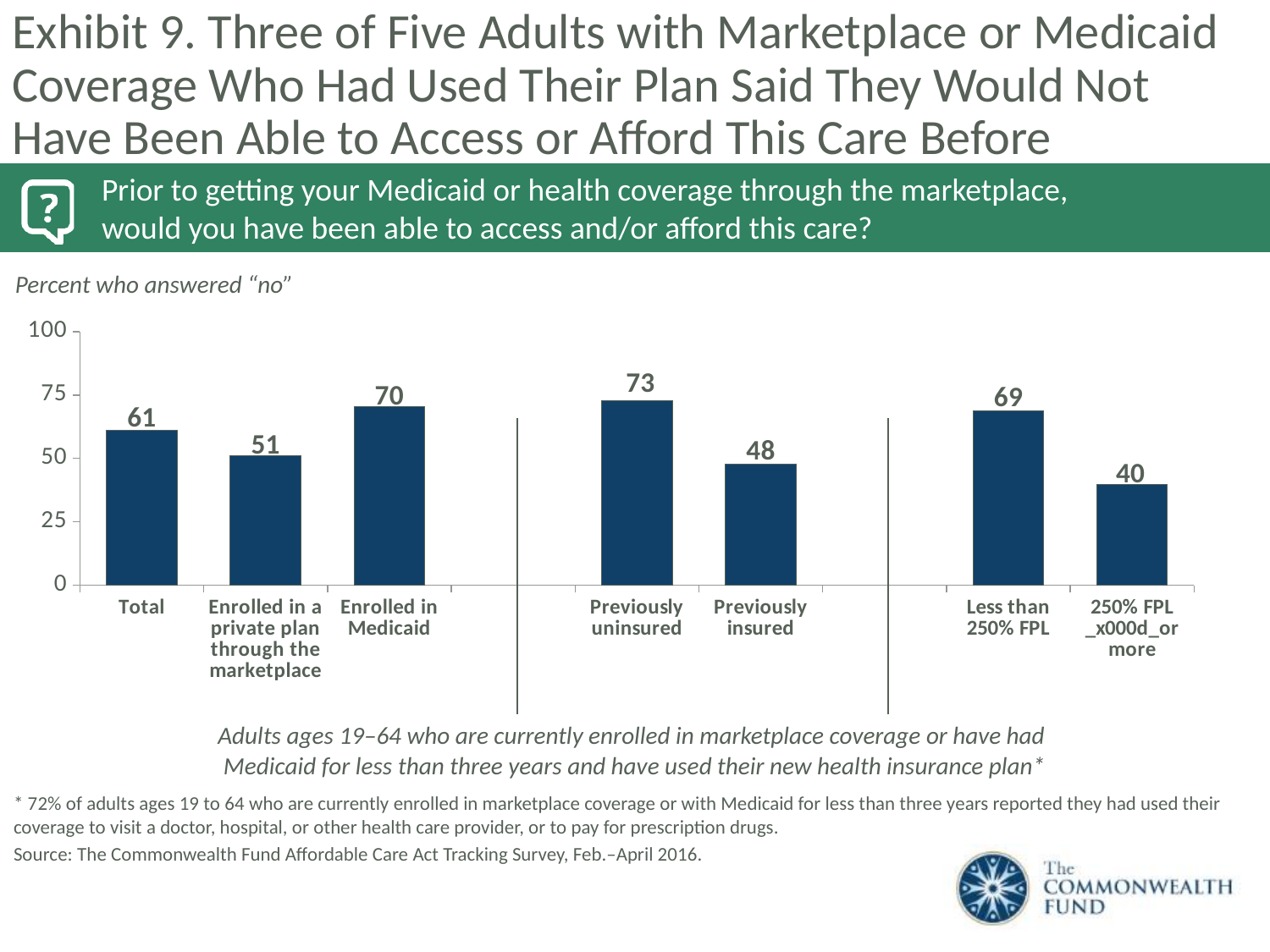
Which is larger, the value for Enrolled in Medicaid or the value for Enrolled in a private plan through the marketplace? Enrolled in Medicaid What is the value for Previously insured? 48 What is the difference between the values for Previously uninsured and Previously insured? 25 What kind of chart is shown on the slide? bar chart What does the label above the chart say the values represent? Percent who answered "no" What is the value for Enrolled in Medicaid? 70 What is the value for Less than 250% FPL? 69 Is the value for Enrolled in a private plan through the marketplace greater or less than 75? less Which category has the highest value? Previously uninsured How many bars are plotted on the chart? 7 Which category has the lowest value? 250% FPL or more What is the value for Total? 61